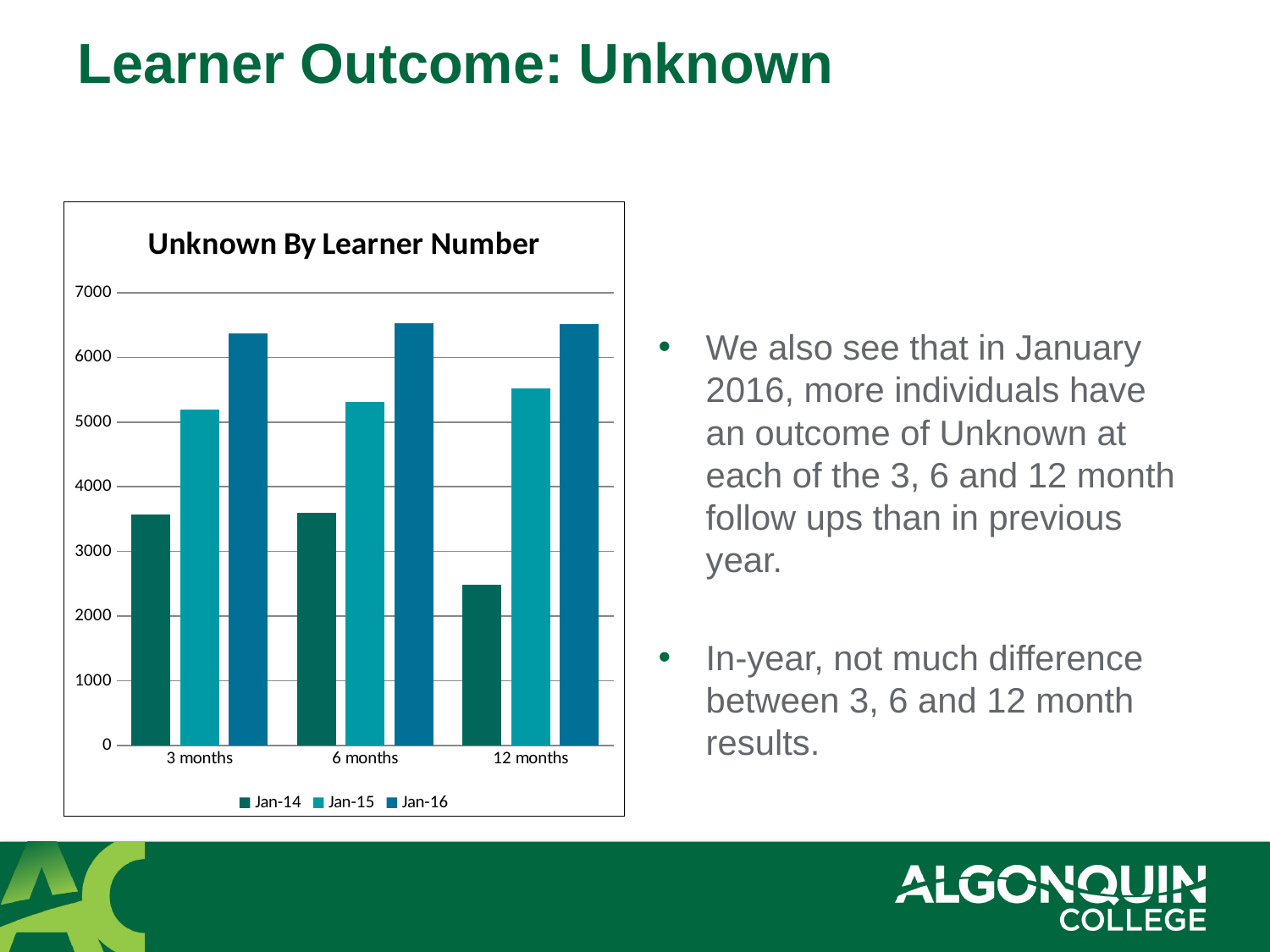
Is the value for Jan-16 at 3 months greater or less than 6000? greater Is the value for Jan-15 at 6 months greater or less than 5000? greater What is the title of the chart? Unknown By Learner Number What kind of chart is shown on the slide? bar chart How many series does the legend list? 3 Do the Jan-15 values rise or fall from 3 months to 12 months? rise Which series has the highest value at 3 months? Jan-16 Which series has the lowest value at 12 months? Jan-14 Is the value for Jan-14 at 12 months greater or less than 3000? less How many categories are shown on the x axis? 3 Which is larger at 12 months, Jan-15 or Jan-14? Jan-15